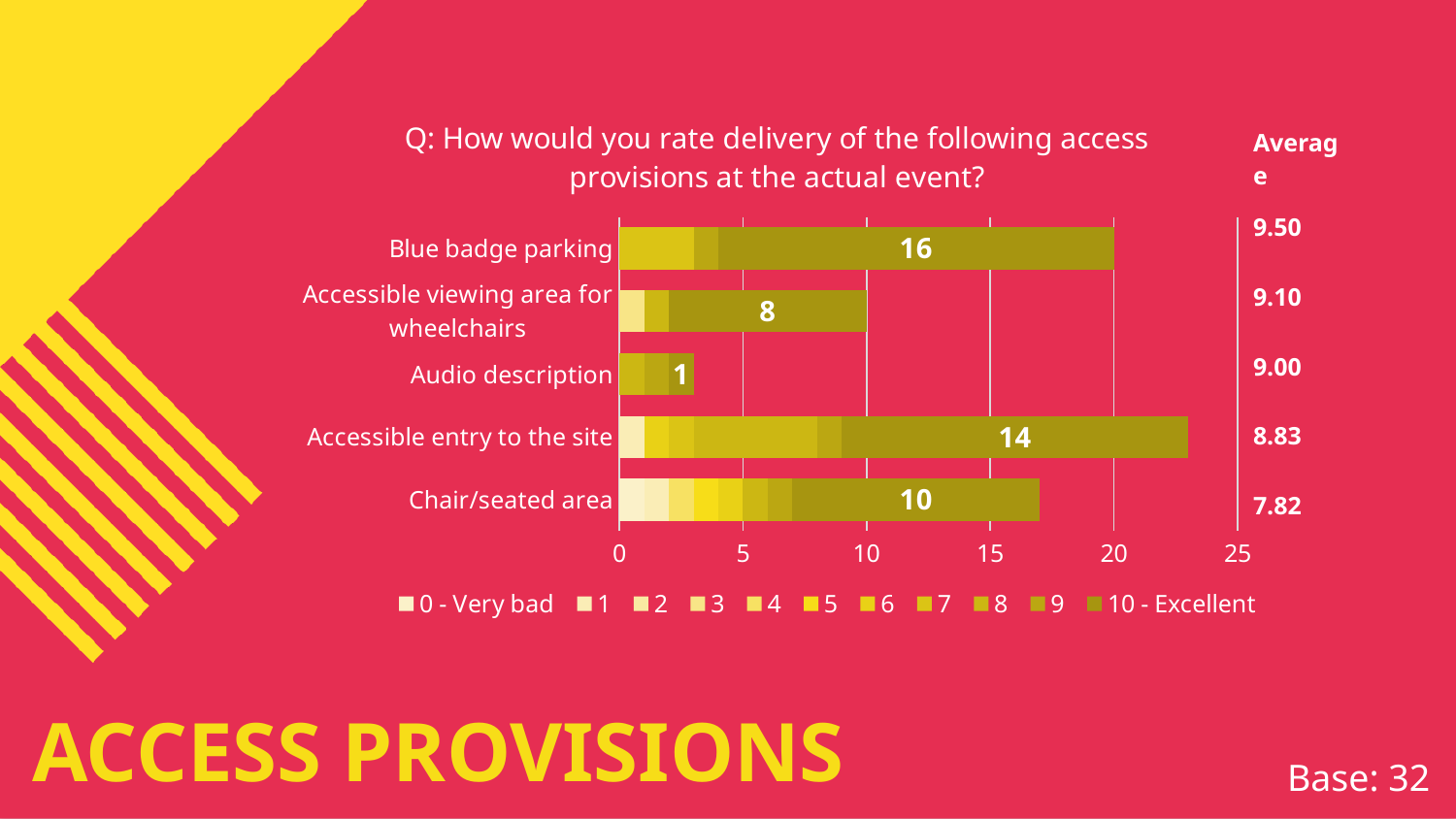
What is the '10 - Excellent' count for Audio description? 1 What is the difference between the '10 - Excellent' counts for Blue badge parking and Accessible viewing area for wheelchairs? 8 What is the '10 - Excellent' count for Accessible entry to the site? 14 What type of chart is shown on the slide? Stacked bar chart How many categories are plotted on the chart? 5 What is the average rating shown for Chair/seated area? 7.82 Is the total bar length for Accessible entry to the site greater or less than 20? greater What is the '10 - Excellent' count for Blue badge parking? 16 Which has a higher average rating, Audio description or Accessible entry to the site? Audio description Which category has the highest average rating? Blue badge parking Which category has the lowest '10 - Excellent' count? Audio description How many series does the legend list? 11